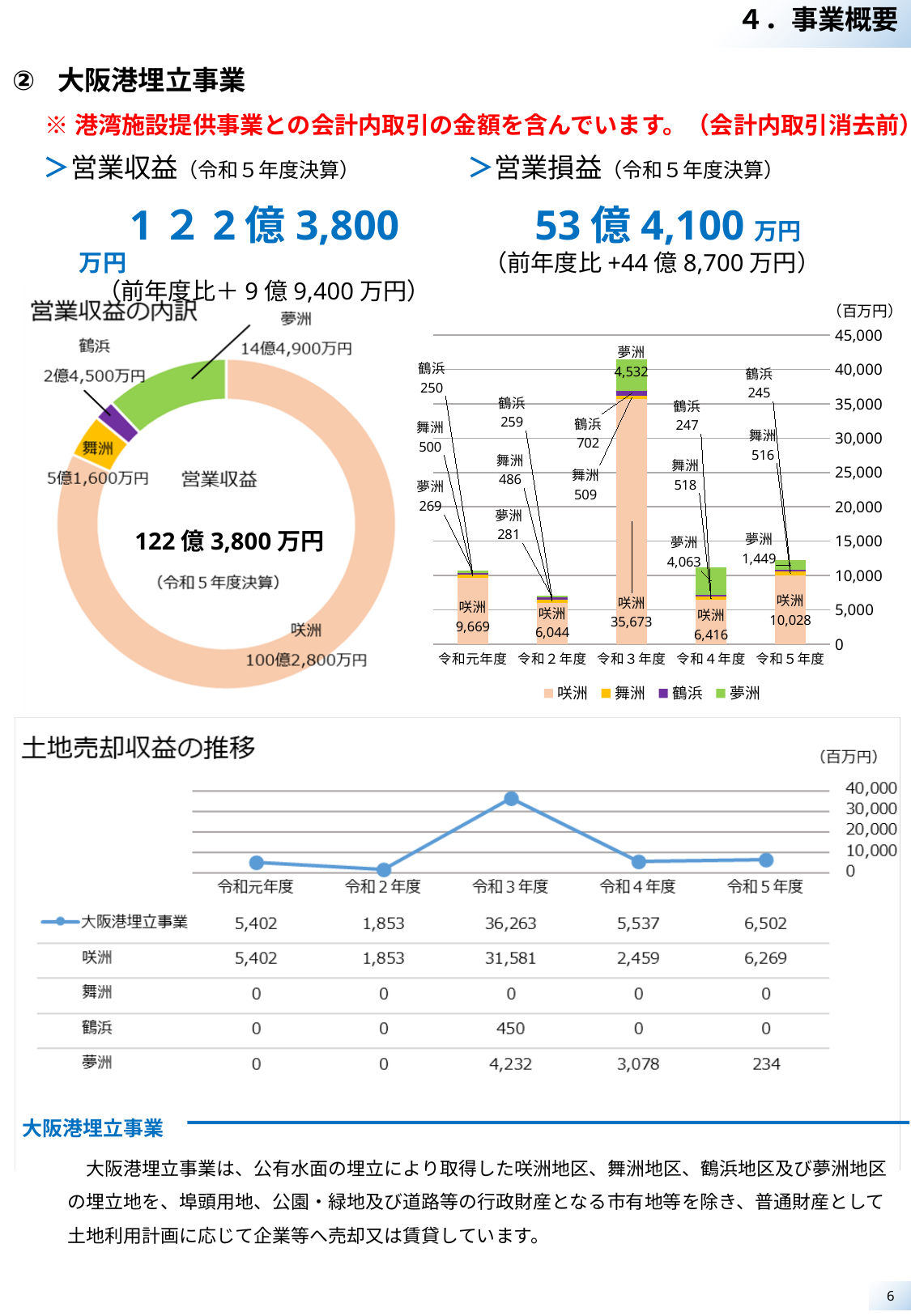
In the stacked bar chart on the right, what is the value for 夢洲 in 令和5年度? 1,449 In the chart 土地売却収益の推移, what is the difference between the 大阪港埋立事業 values for 令和5年度 and 令和4年度? 965 In the donut chart 営業収益の内訳, what is the value for 咲洲? 100億2,800万円 In the stacked bar chart on the right, which year has the tallest bar? 令和3年度 In the chart 土地売却収益の推移, which year has the lowest value for 大阪港埋立事業? 令和2年度 What kind of chart is 土地売却収益の推移? line chart In the stacked bar chart on the right, what is the total of the 令和元年度 bar? 10,688 In the chart 土地売却収益の推移, what is the value for 大阪港埋立事業 in 令和3年度? 36,263 In the stacked bar chart on the right (営業損益 section), what is the value for 咲洲 in 令和3年度? 35,673 In the stacked bar chart on the right, how many series does the legend list? 4 In the stacked bar chart on the right, is the value for 鶴浜 larger in 令和2年度 or 令和3年度? 令和3年度 In the donut chart 営業収益の内訳, which district has the smallest slice? 鶴浜